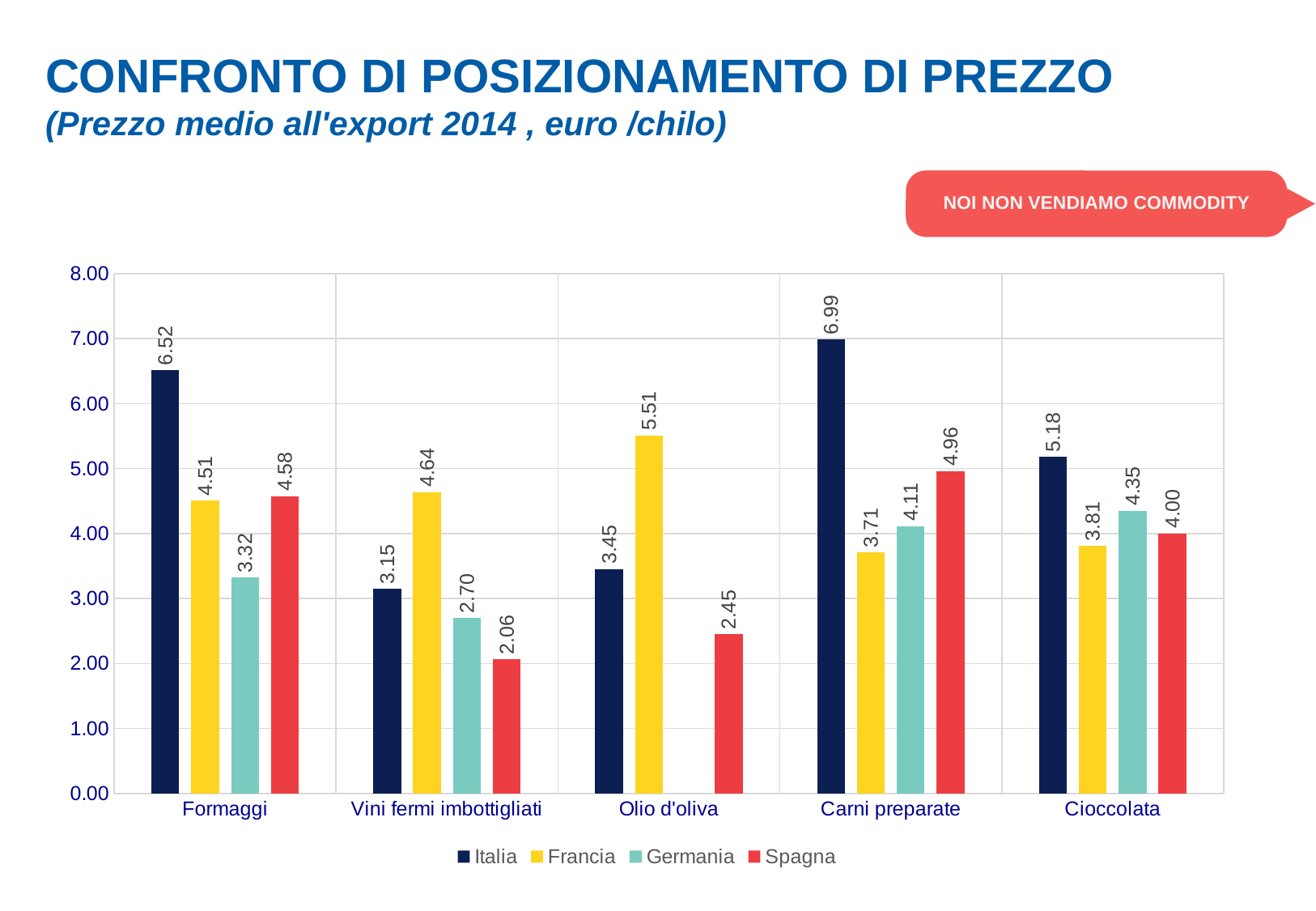
Which is larger in the Cioccolata category: the value for Italia or the value for Germania? Italia What is the value for Italia in the Formaggi category? 6.52 Which country has the lowest value in the Carni preparate category? Francia What is the value for Spagna in the Vini fermi imbottigliati category? 2.06 In which category does Italia have its highest value? Carni preparate What is the value for Germania in the Cioccolata category? 4.35 What is the difference between the Italia and Francia values for Formaggi? 2.01 Is the value for Spagna in the Carni preparate category greater or less than 4.00? greater How many product categories are shown on the x axis? 5 How many series does the legend list? 4 What kind of chart is shown on the slide? Bar chart What is the value for Francia in the Olio d'oliva category? 5.51